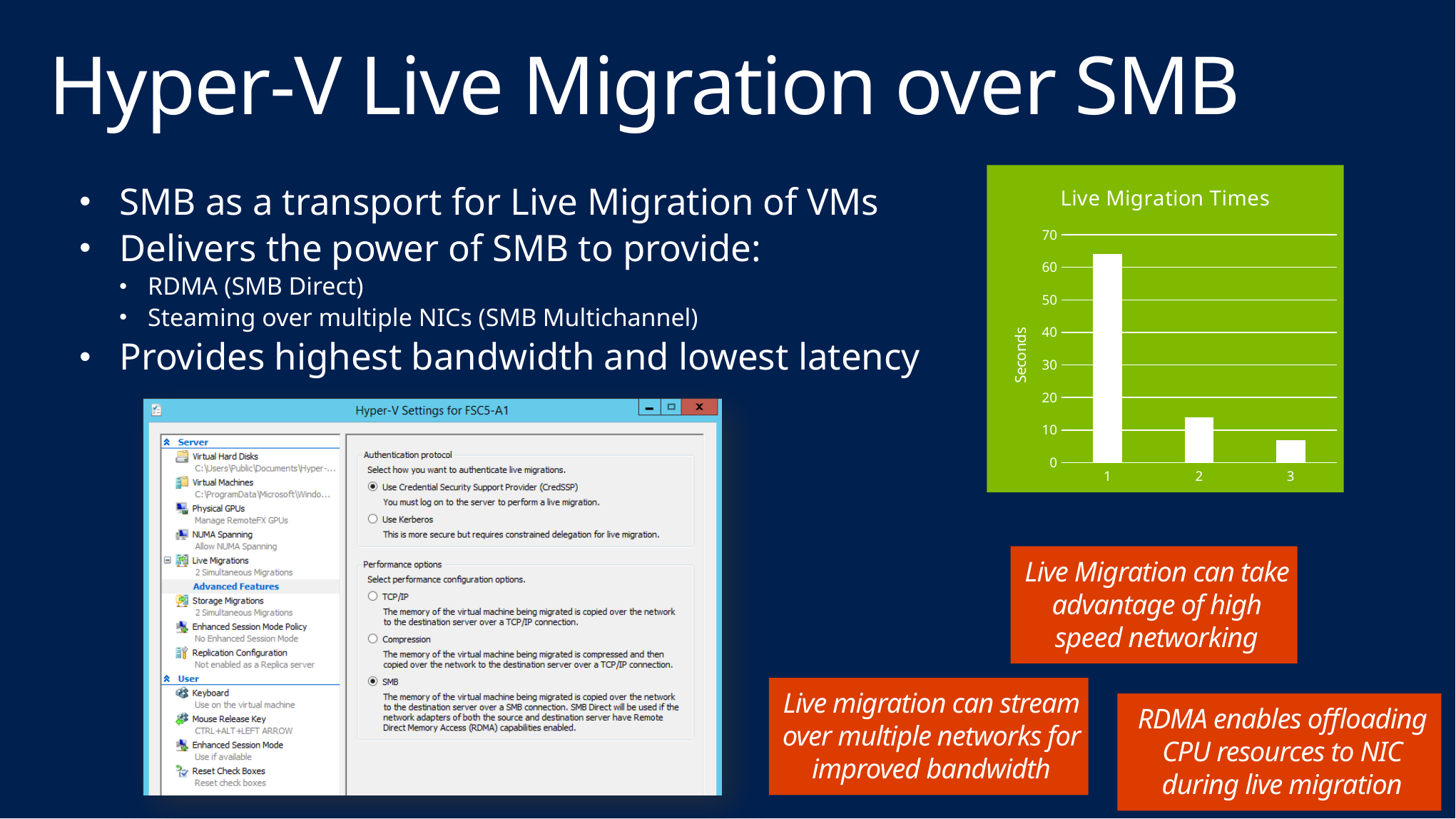
Which category has the highest value in the Live Migration Times chart? 1 Is the value for category 1 greater or less than 60? greater What kind of chart is shown on the slide? bar chart What is the label on the vertical axis of the chart? Seconds Which category has the lowest value in the Live Migration Times chart? 3 Which is larger in the Live Migration Times chart, the value for category 2 or category 3? 2 How many bars are plotted in the Live Migration Times chart? 3 What is the title of the chart? Live Migration Times Do the values in the Live Migration Times chart rise or fall from category 1 to category 3? fall What is the highest tick value shown on the vertical axis of the chart? 70 Is the value for category 2 greater or less than 20? less Is the value for category 3 greater or less than 10? less